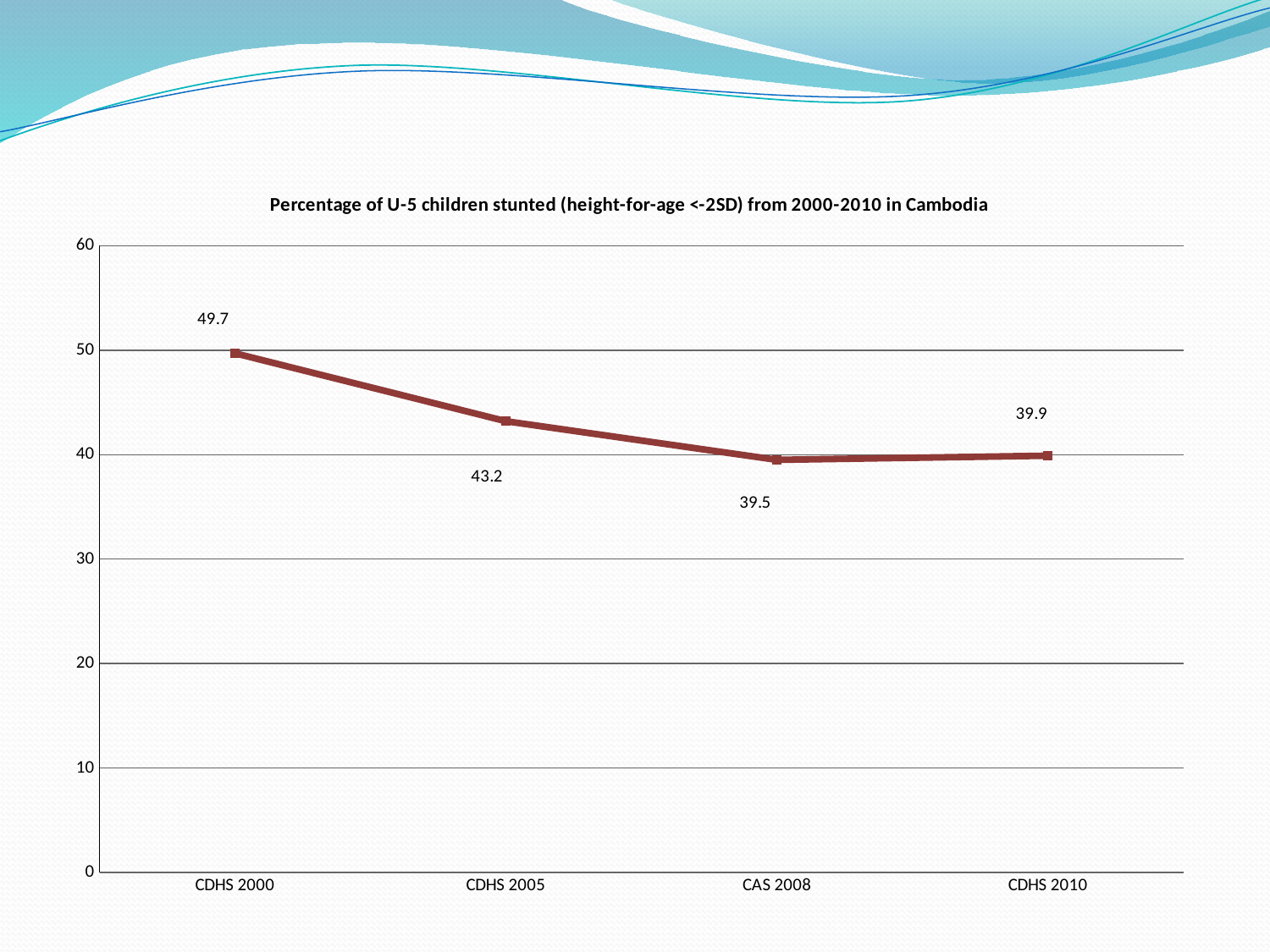
What is the difference between the values for CDHS 2000 and CDHS 2005? 6.5 What is the value for CDHS 2005? 43.2 Which survey has the highest stunting percentage? CDHS 2000 What is the value for CAS 2008? 39.5 Does the stunting percentage generally rise or fall from CDHS 2000 to CDHS 2010? Fall How many data points are plotted on the chart? 4 What is the value for CDHS 2010? 39.9 Which is larger, the value for CDHS 2005 or the value for CAS 2008? CDHS 2005 What is the difference between the values for CDHS 2000 and CDHS 2010? 9.8 Which survey has the lowest stunting percentage? CAS 2008 What is the value for CDHS 2000? 49.7 What kind of chart is shown on the slide? Line chart